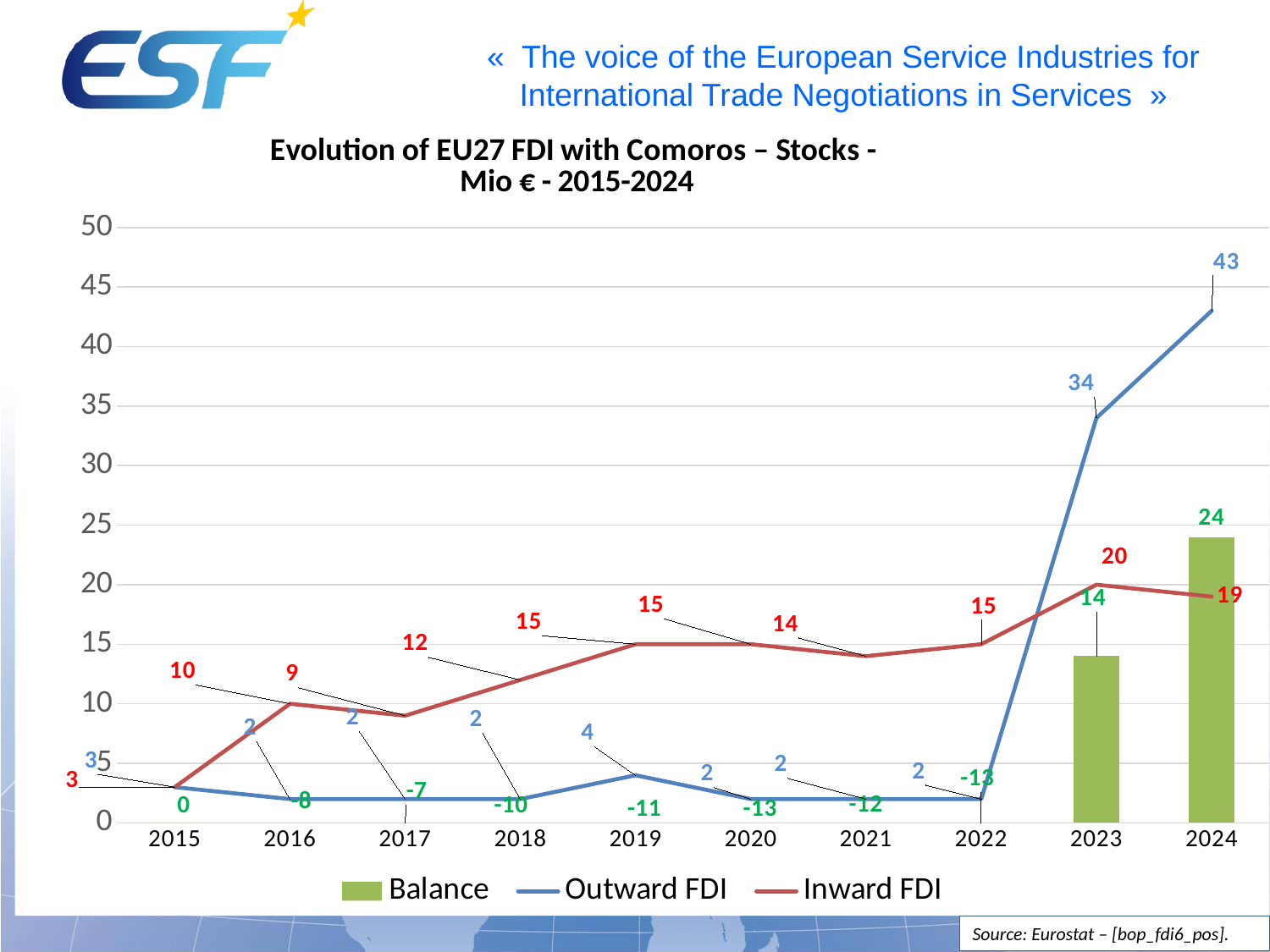
What is the Outward FDI value for 2024? 43 Which series is shown as green bars? Balance Which is larger in 2019, Inward FDI or Outward FDI? Inward FDI Is the Outward FDI value for 2023 greater or less than 30? greater What is the Balance value for 2020? -13 How many years are shown on the x axis? 10 What is the difference between Outward FDI in 2024 and 2023? 9 What is the Inward FDI value for 2023? 20 In which year is the Balance lowest? 2020 and 2022 How many series does the legend list? 3 In which year is Outward FDI highest? 2024 What kind of chart is this? Combined bar and line chart